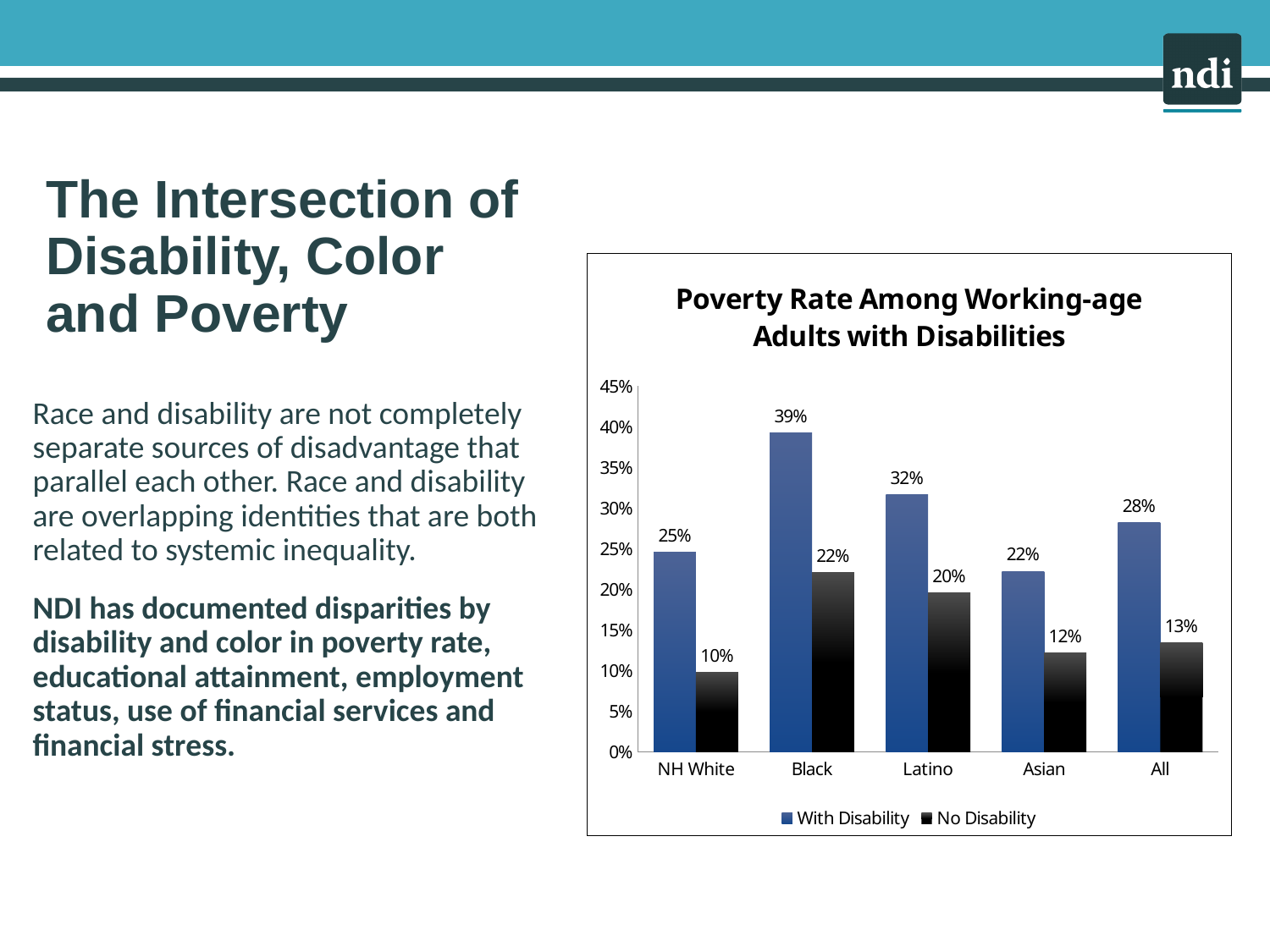
What is the poverty rate for Asian working-age adults with no disability? 12% How many series does the legend list? 2 How many categories are shown on the x axis? 5 What is the poverty rate for NH White working-age adults with no disability? 10% What is the difference between the With Disability poverty rates for Black and NH White adults? 14% Which category has the lowest poverty rate in the No Disability series? NH White What is the poverty rate for Black working-age adults with a disability? 39% What is the difference between the With Disability and No Disability poverty rates for Latino adults? 12% What type of chart is shown on the slide? Bar chart Which is larger: the With Disability poverty rate for Asian adults or the No Disability poverty rate for Black adults? They are equal (22%) Which category has the highest poverty rate in the With Disability series? Black Which is larger: the With Disability poverty rate for Latino adults or for All adults? Latino